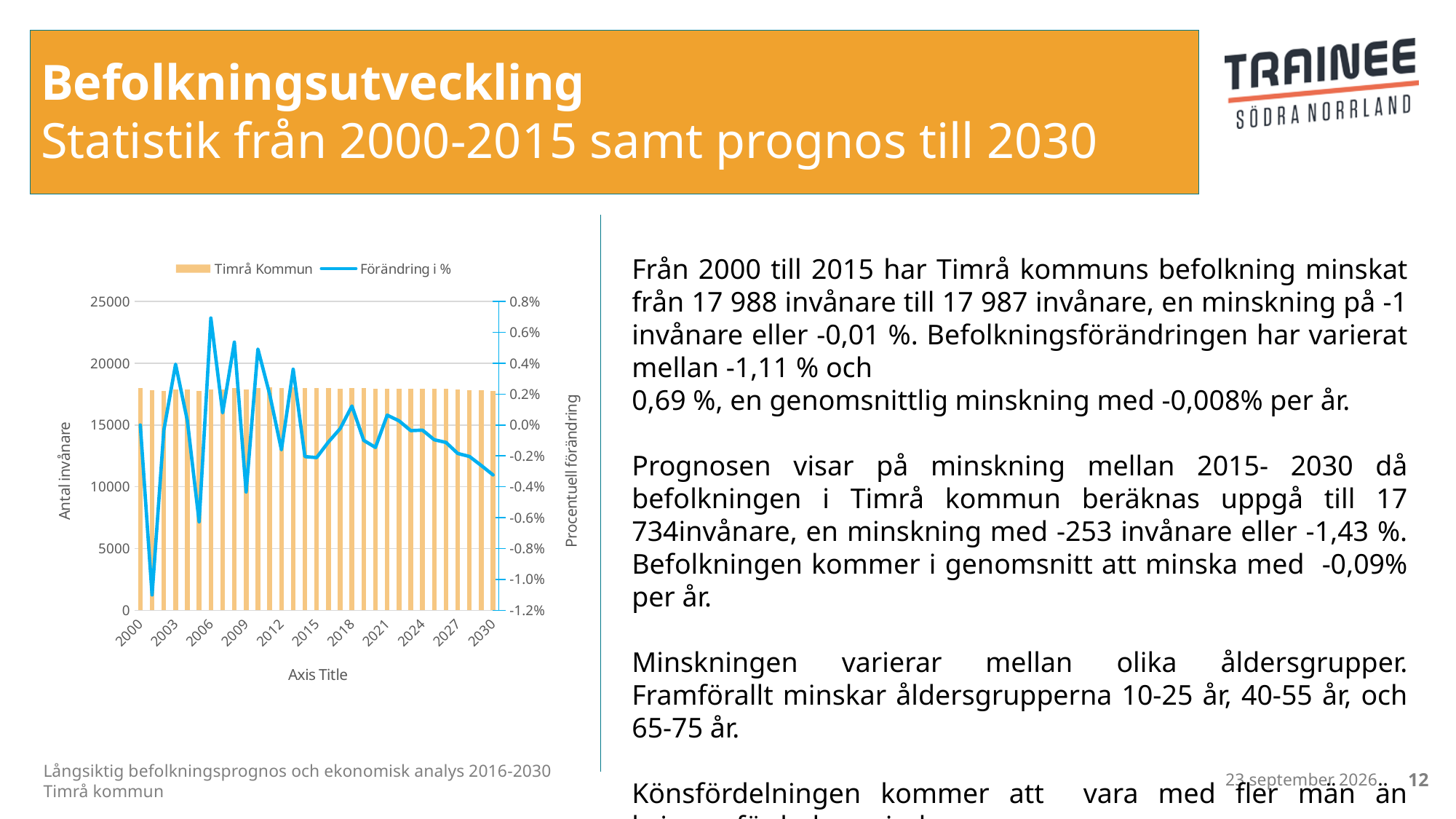
Is the Förändring i % value for 2001 greater or less than -1.0%? less Is the Timrå Kommun bar for 2015 greater or less than 20000? less Does the Förändring i % line rise or fall from 2021 to 2030? fall How many series does the chart legend list? 2 What kind of chart is shown on the slide? A combined bar and line chart In which year does the Förändring i % line reach its lowest value? 2001 Is the Förändring i % value for 2030 greater or less than 0.0%? less In which year does the Förändring i % line reach its highest value? 2006 Which series is drawn as bars in the chart? Timrå Kommun Which year has the higher Förändring i % value, 2006 or 2009? 2006 What is the title of the left vertical axis of the chart? Antal invånare